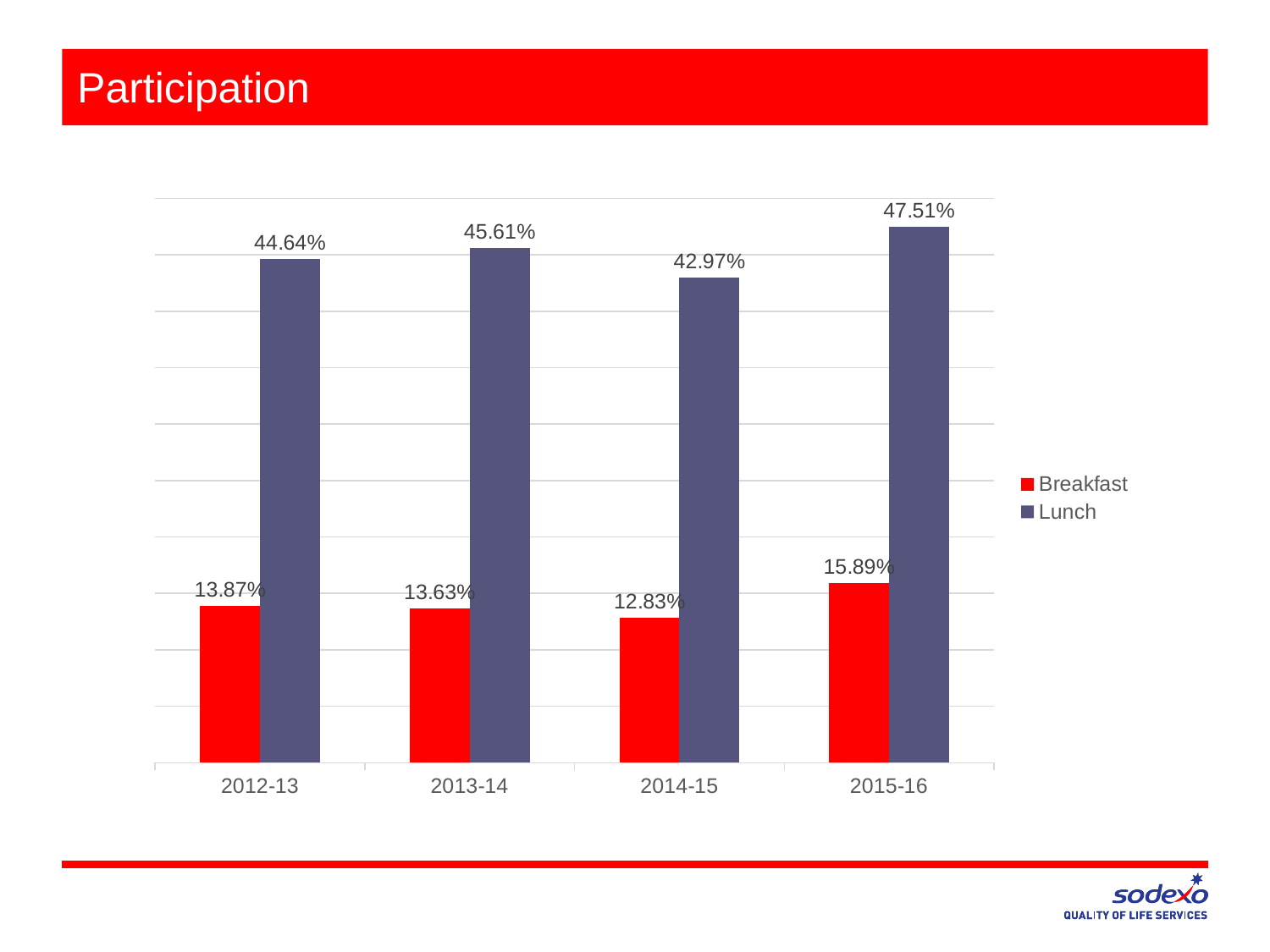
What kind of chart is shown on the slide? Bar chart How many years are shown on the x axis? 4 What is the Lunch participation value for 2014-15? 42.97% Which year has the highest Breakfast participation? 2015-16 What is the difference between the Lunch and Breakfast values in 2012-13? 30.77 percentage points Which year has the lowest Lunch participation? 2014-15 Which year has the lowest Breakfast participation? 2014-15 What is the Lunch participation value for 2015-16? 47.51% How many series does the legend list? 2 What is the difference between the Lunch values for 2015-16 and 2014-15? 4.54 percentage points What is the Breakfast participation value for 2013-14? 13.63% Which is larger, the Lunch value for 2012-13 or the Lunch value for 2013-14? 2013-14